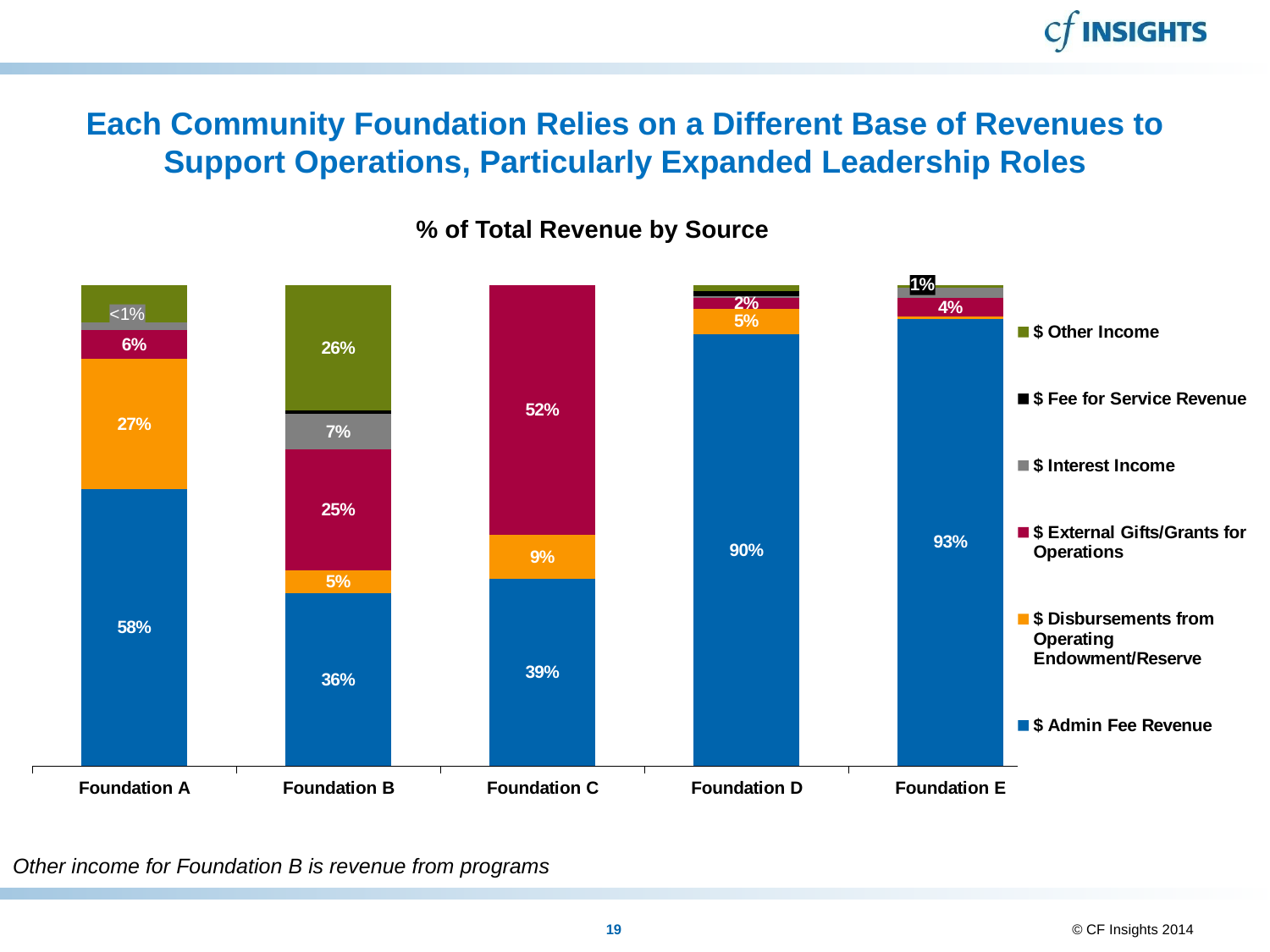
How many percentage points higher is Foundation E's $ Admin Fee Revenue share than Foundation D's? 3 percentage points What is the $ Other Income share for Foundation B? 26% What is the $ External Gifts/Grants for Operations share for Foundation C? 52% What is the $ Disbursements from Operating Endowment/Reserve share for Foundation D? 5% How many revenue sources does the legend list? 6 What type of chart is shown on the slide? Stacked bar chart What is the $ Interest Income share for Foundation B? 7% Which foundation has the highest $ Admin Fee Revenue share? Foundation E What percentage of Foundation A's total revenue comes from $ Admin Fee Revenue? 58% How many foundations are shown on the x axis? 5 Which foundation has the lowest $ Admin Fee Revenue share? Foundation B Which has a larger $ Disbursements from Operating Endowment/Reserve share, Foundation A or Foundation C? Foundation A